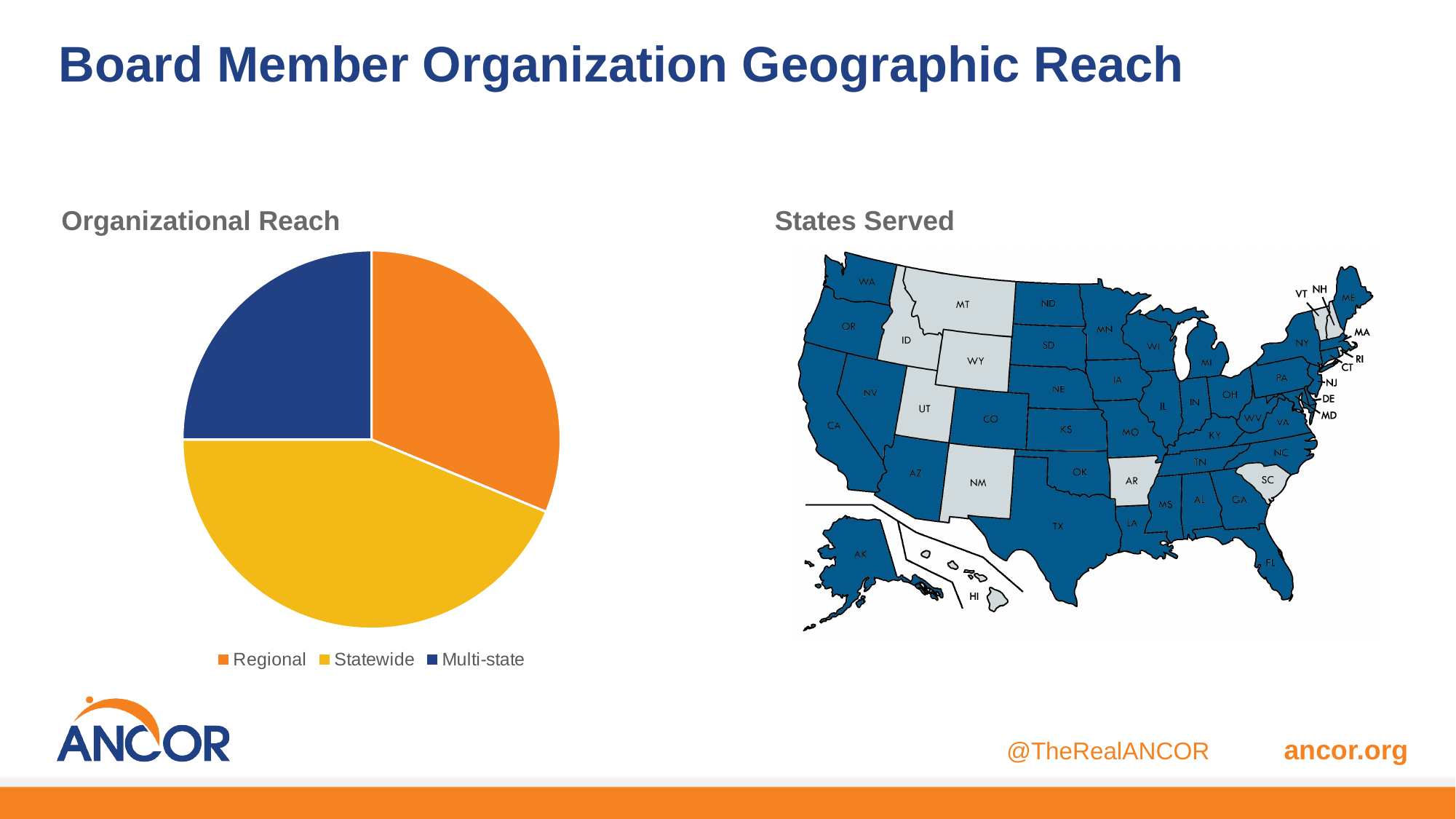
In the Organizational Reach pie chart, which slice is larger, Regional or Multi-state? Regional In the Organizational Reach pie chart, which slice is larger, Statewide or Multi-state? Statewide How many entries does the legend of the Organizational Reach chart list? 3 What kind of chart is the Organizational Reach chart? pie chart What colour is the Statewide slice in the Organizational Reach pie chart? yellow How many slices does the Organizational Reach pie chart have? 3 What is the title of the pie chart on the slide? Organizational Reach Which category has the smallest slice in the Organizational Reach pie chart? Multi-state Which category has the largest slice in the Organizational Reach pie chart? Statewide